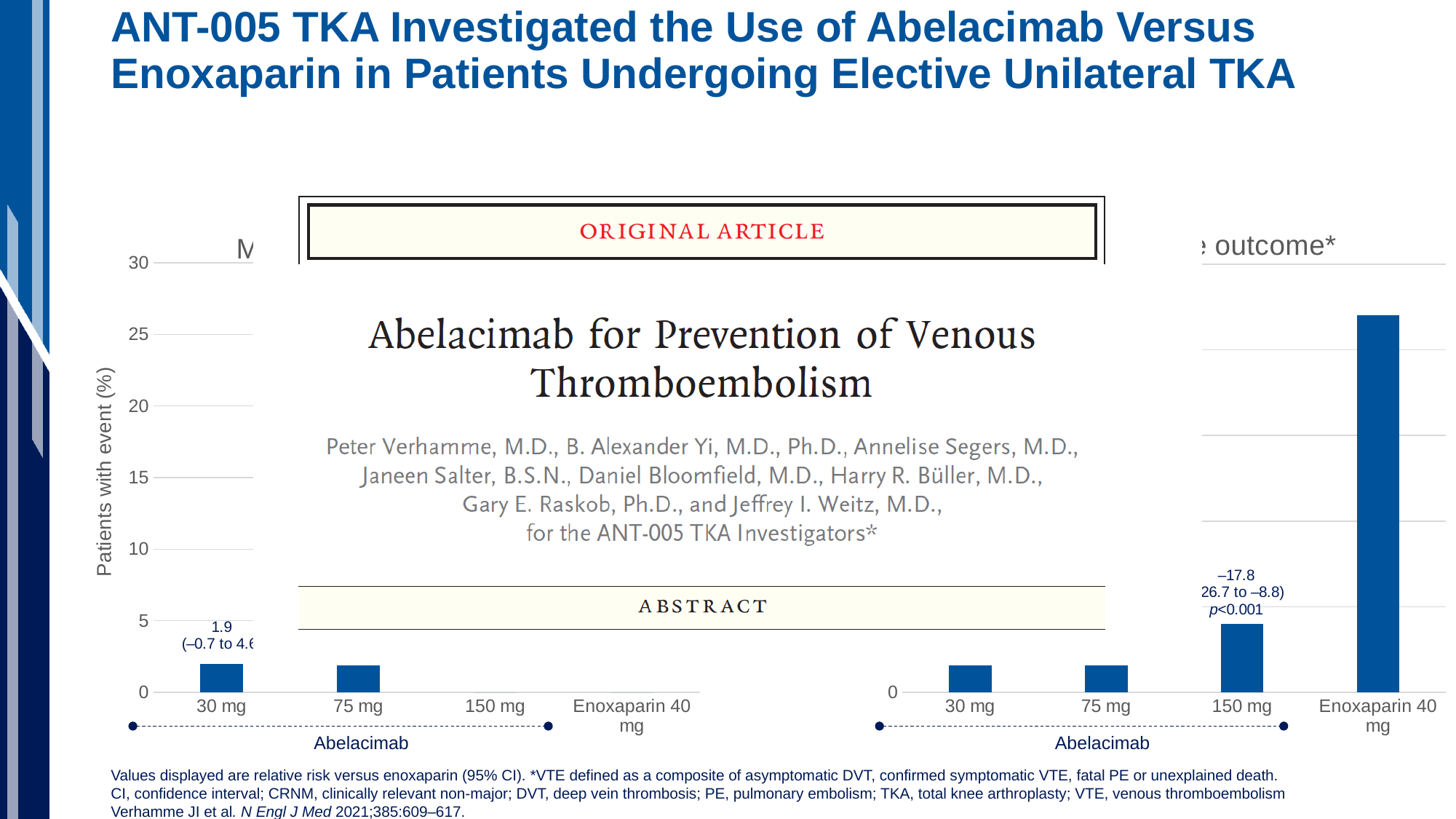
What kind of chart is the chart on the left of the slide? bar chart How many categories are shown on the x axis of the chart on the right of the slide? 4 In the chart on the right of the slide, which category has the highest bar? Enoxaparin 40 mg What is the highest tick value shown on the y axis of the chart on the left of the slide? 30 In the chart on the right of the slide, is the value for 30 mg greater or less than 5? less In the chart on the left of the slide, is the value for 30 mg greater or less than 5? less In the chart on the right of the slide, which is larger, the value for 150 mg or the value for Enoxaparin 40 mg? Enoxaparin 40 mg In the chart on the right of the slide, is the value for Enoxaparin 40 mg greater or less than 25? less What is the y-axis label of the chart on the left of the slide? Patients with event (%) In the chart on the right of the slide, which drug name is bracketed under the 30 mg, 75 mg and 150 mg categories? Abelacimab In the chart on the right of the slide, which is larger, the value for 30 mg or the value for 150 mg? 150 mg